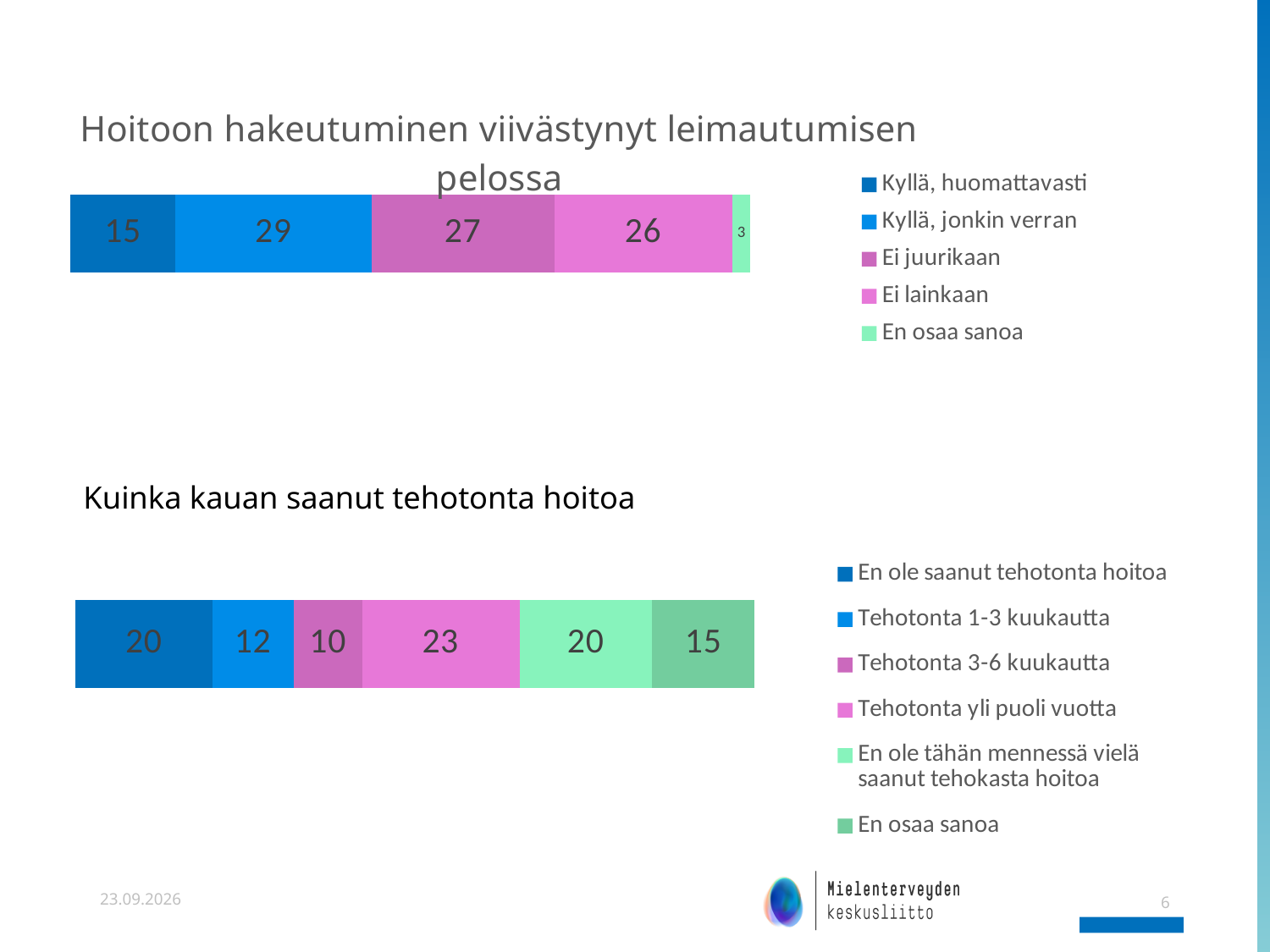
In the chart titled "Hoitoon hakeutuminen viivästynyt leimautumisen pelossa", how many series does the legend list? 5 What type of chart is the chart titled "Kuinka kauan saanut tehotonta hoitoa"? Stacked bar chart In the chart titled "Hoitoon hakeutuminen viivästynyt leimautumisen pelossa", what is the total of the stacked bar? 100 In the chart titled "Kuinka kauan saanut tehotonta hoitoa", which series has the smallest value? Tehotonta 3-6 kuukautta In the chart titled "Hoitoon hakeutuminen viivästynyt leimautumisen pelossa", what is the value for "Kyllä, jonkin verran"? 29 In the chart titled "Kuinka kauan saanut tehotonta hoitoa", which is larger: "Tehotonta 1-3 kuukautta" or "En osaa sanoa"? En osaa sanoa In the chart titled "Hoitoon hakeutuminen viivästynyt leimautumisen pelossa", what is the value for "En osaa sanoa"? 3 In the chart titled "Kuinka kauan saanut tehotonta hoitoa", what is the value for "Tehotonta yli puoli vuotta"? 23 In the chart titled "Hoitoon hakeutuminen viivästynyt leimautumisen pelossa", which series has the largest value? Kyllä, jonkin verran In the chart titled "Hoitoon hakeutuminen viivästynyt leimautumisen pelossa", what is the difference between "Kyllä, jonkin verran" and "Kyllä, huomattavasti"? 14 In the chart titled "Kuinka kauan saanut tehotonta hoitoa", how many series does the legend list? 6 In the chart titled "Kuinka kauan saanut tehotonta hoitoa", what is the value for "Tehotonta 3-6 kuukautta"? 10